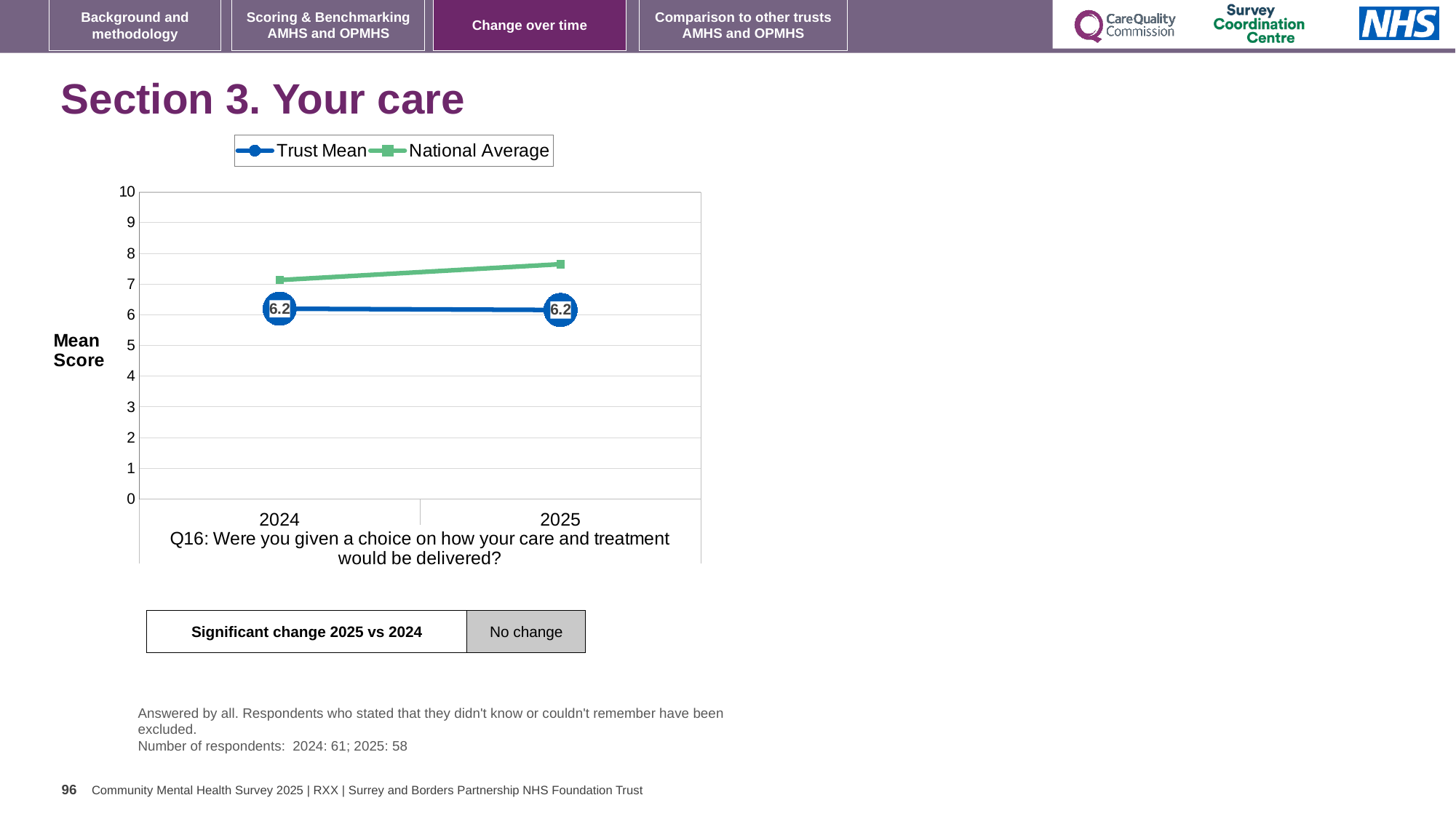
What is the label on the y axis of the chart? Mean Score What is the difference between the Trust Mean in 2025 and in 2024? 0 How many series does the legend list? 2 Is the National Average value for 2024 greater or less than 8? less In 2025, which is higher: the Trust Mean or the National Average? National Average Does the National Average rise or fall from 2024 to 2025? Rises What is the Trust Mean value for 2025? 6.2 What is the Trust Mean value for 2024? 6.2 How many years are plotted on the x axis? 2 What kind of chart is shown on the slide? Line chart Is the National Average value for 2025 greater or less than 7? greater Does the Trust Mean rise, fall or stay the same from 2024 to 2025? Stays the same